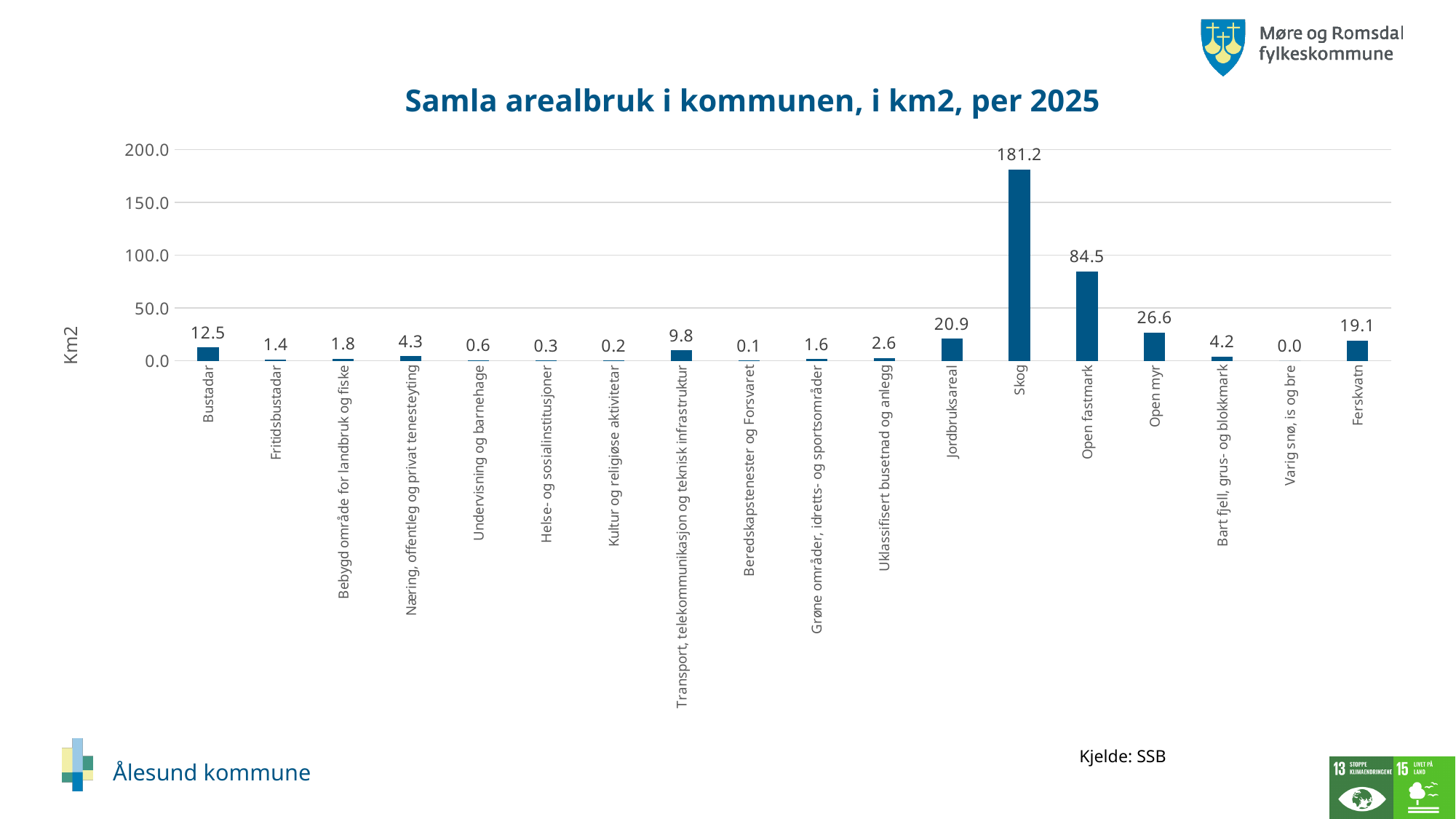
Which category has the lowest value? Varig snø, is og bre Which category has the highest value? Skog How many categories are shown on the x axis? 18 Is the value for Open fastmark greater or less than 100.0? less What is the title of the chart? Samla arealbruk i kommunen, i km2, per 2025 What is the value for Bustadar? 12.5 Which is larger, the value for Open myr or the value for Jordbruksareal? Open myr What is the value for Ferskvatn? 19.1 What is the value for Skog? 181.2 What is the difference between the values for Skog and Open fastmark? 96.7 What is the value for Open fastmark? 84.5 What kind of chart is shown on the slide? Bar chart